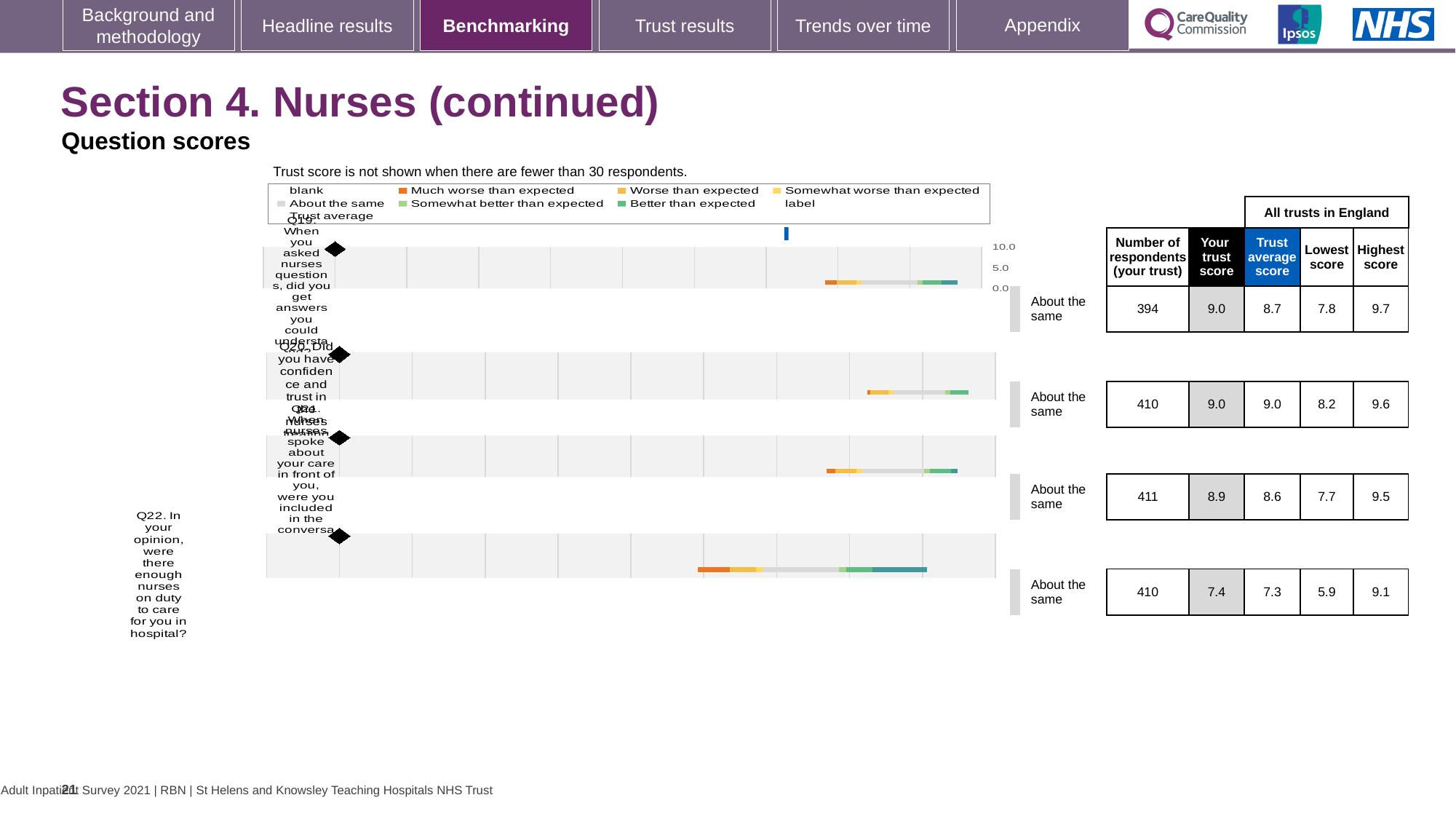
What is the difference between the trust's score and the trust average score for Q19? 0.3 What is the 'Your trust score' for Q22 (were there enough nurses on duty)? 7.4 What is the trust average score for Q20? 9.0 How many respondents answered Q19 for this trust? 394 Which legend entry is shown in orange? Much worse than expected Which question has the lowest 'Your trust score'? Q22 How many questions are plotted in the chart? 4 What kind of chart is used to show the question scores on this slide? bar chart What is the lowest score across all trusts in England for Q21? 7.7 For Q21, which is larger: the trust's own score or the trust average score? Your trust score What is the highest score across all trusts in England for Q20? 9.6 What is the difference between the highest score and the lowest score for Q22? 3.2